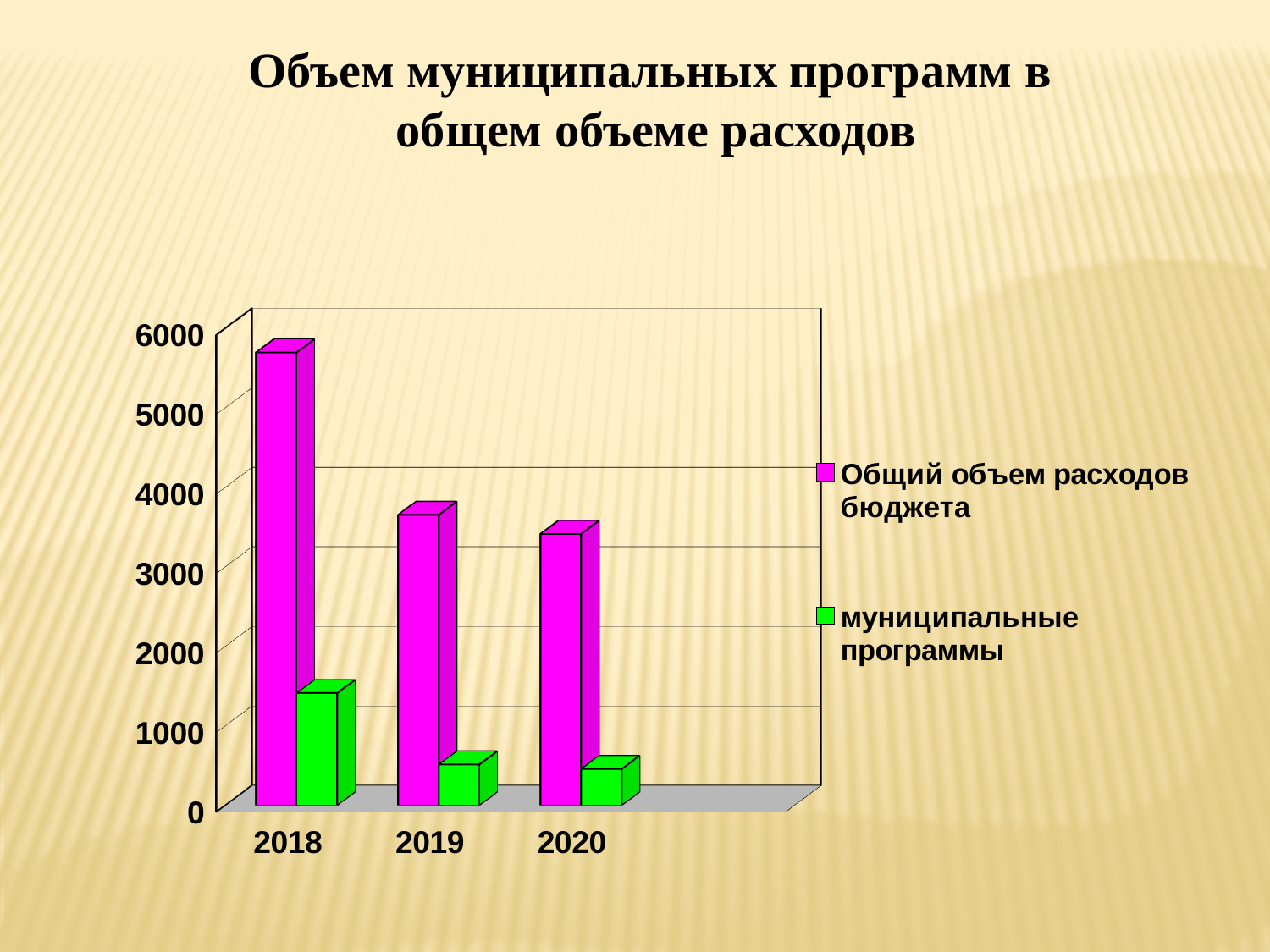
In 2019, which is larger: Общий объем расходов бюджета or муниципальные программы? Общий объем расходов бюджета Which year has the highest value for муниципальные программы? 2018 Which year has the highest value for Общий объем расходов бюджета? 2018 How many years are shown on the x axis? 3 What kind of chart is shown on the slide? bar chart Is the value for муниципальные программы in 2018 greater or less than 1000? greater What colour are the bars for муниципальные программы? green Do the values for Общий объем расходов бюджета rise or fall from 2018 to 2020? fall Is the value for муниципальные программы in 2019 greater or less than 1000? less How many series does the legend list? 2 Is the value for Общий объем расходов бюджета in 2018 greater or less than 5000? greater